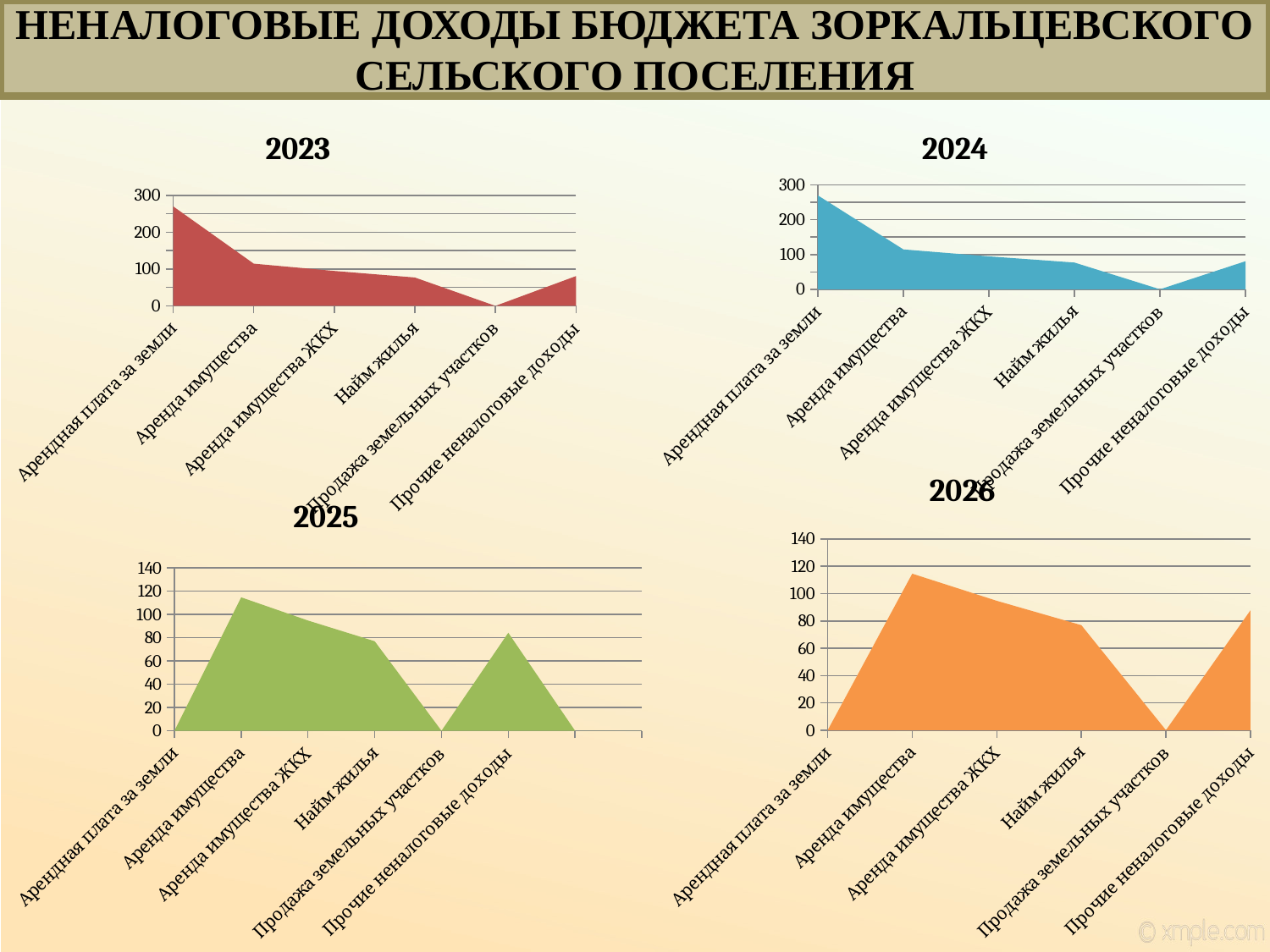
In the 2026 chart, which is larger: Аренда имущества or Прочие неналоговые доходы? Аренда имущества In the 2024 chart, do the values rise or fall from Арендная плата за земли to Продажа земельных участков? fall How many charts are shown on the slide? 4 What kind of chart is the 2023 chart? area chart In the 2025 chart, is the value for Аренда имущества greater or less than 100? greater How many categories are shown on the x axis of the 2025 chart? 6 In the 2025 chart, which category has the highest value? Аренда имущества In the 2024 chart, which category has the lowest value? Продажа земельных участков In the 2023 chart, which category has the highest value? Арендная плата за земли In the 2023 chart, which is larger: Аренда имущества or Найм жилья? Аренда имущества In the 2023 chart, is the value for Арендная плата за земли greater or less than 200? greater In the 2026 chart, is the value for Найм жилья greater or less than 100? less